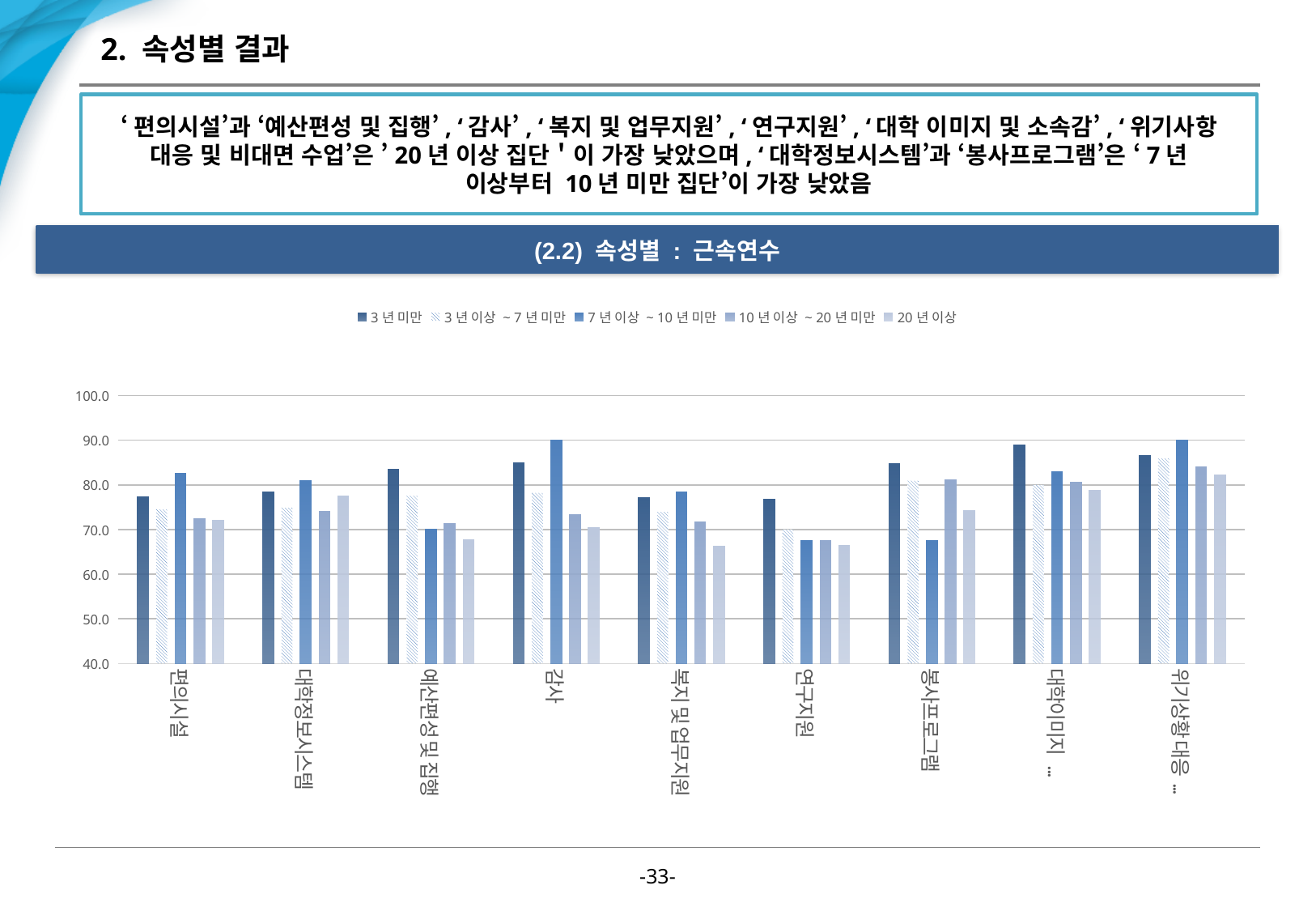
How many series does the chart legend list? 5 For 편의시설, which is larger: the 3년 미만 bar or the 20년 이상 bar? 3년 미만 Within the 봉사프로그램 category, which series has the lowest bar? 7년 이상~10년 미만 Is the value for 봉사프로그램 in the 7년 이상~10년 미만 series greater or less than 70? less Within the 연구지원 category, which series has the highest bar? 3년 미만 Is the value for 감사 in the 7년 이상~10년 미만 series greater or less than 80? greater How many categories are shown along the x axis of the chart? 9 Is the value for 연구지원 in the 3년 미만 series greater or less than 70? greater For 감사, which is larger: the 3년 미만 bar or the 7년 이상~10년 미만 bar? 7년 이상~10년 미만 What is the lowest value shown on the chart's y axis? 40.0 What kind of chart is shown on the slide? bar chart